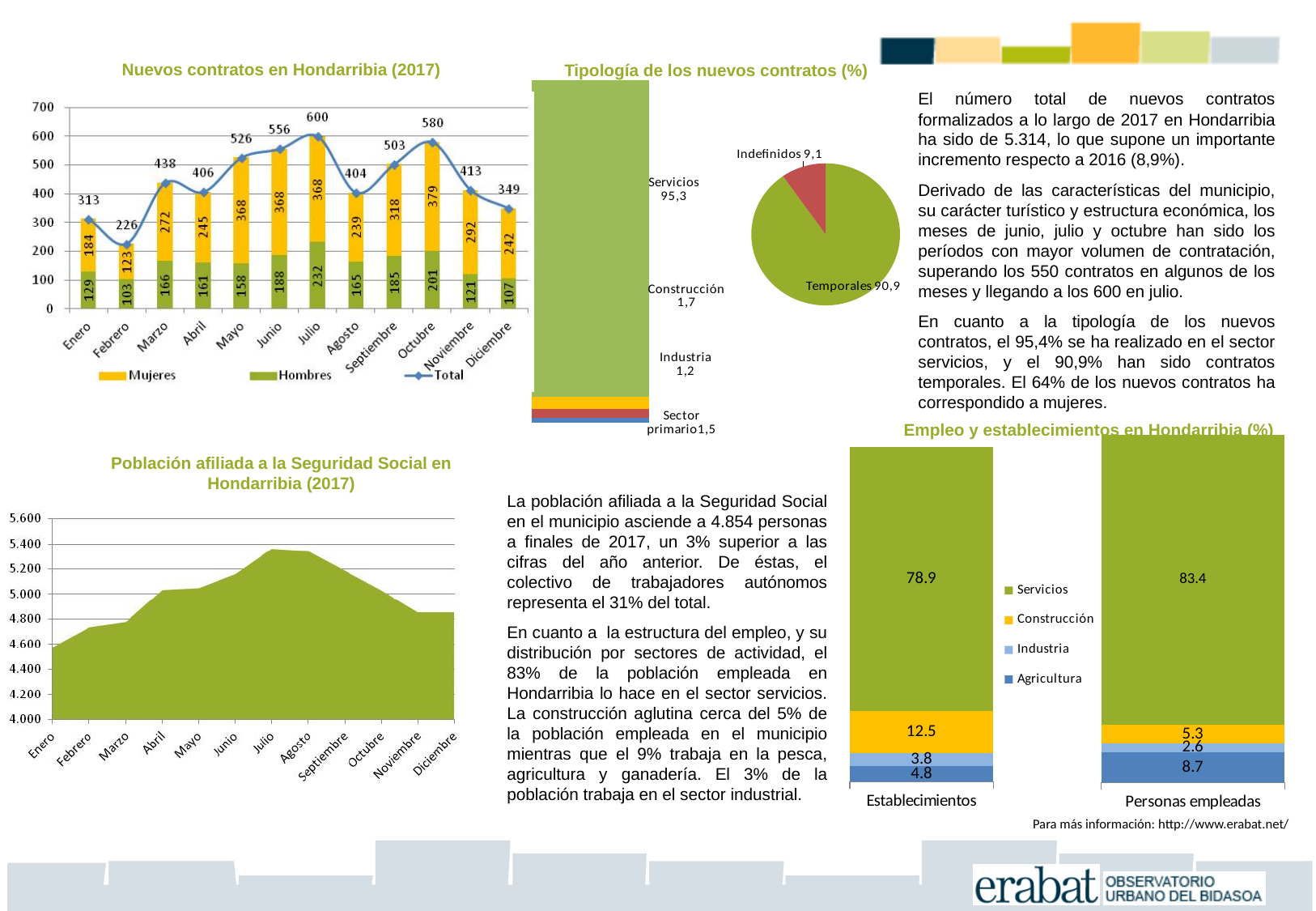
How many series does the legend of the 'Nuevos contratos en Hondarribia (2017)' chart list? 3 In the 'Población afiliada a la Seguridad Social en Hondarribia (2017)' chart, is the value for Julio greater or less than 5.200? greater In the 'Empleo y establecimientos en Hondarribia (%)' chart, is the Construcción value larger for Establecimientos or for Personas empleadas? Establecimientos In the 'Nuevos contratos en Hondarribia (2017)' chart, what is the Total value for Julio? 600 In the 'Nuevos contratos en Hondarribia (2017)' chart, what is the difference between the Mujeres and Hombres values for Marzo? 106 In the pie chart under 'Tipología de los nuevos contratos (%)', what share do Temporales contracts have? 90,9 In the 'Nuevos contratos en Hondarribia (2017)' chart, what is the Mujeres value for Octubre? 379 In the stacked bar under 'Tipología de los nuevos contratos (%)', what is the value for Servicios? 95,3 In the 'Nuevos contratos en Hondarribia (2017)' chart, which month has the lowest Total? Febrero In the 'Empleo y establecimientos en Hondarribia (%)' chart, what is the Servicios value for Personas empleadas? 83.4 How many months are shown on the x axis of the 'Nuevos contratos en Hondarribia (2017)' chart? 12 In the 'Nuevos contratos en Hondarribia (2017)' chart, what is the Hombres value for Febrero? 103